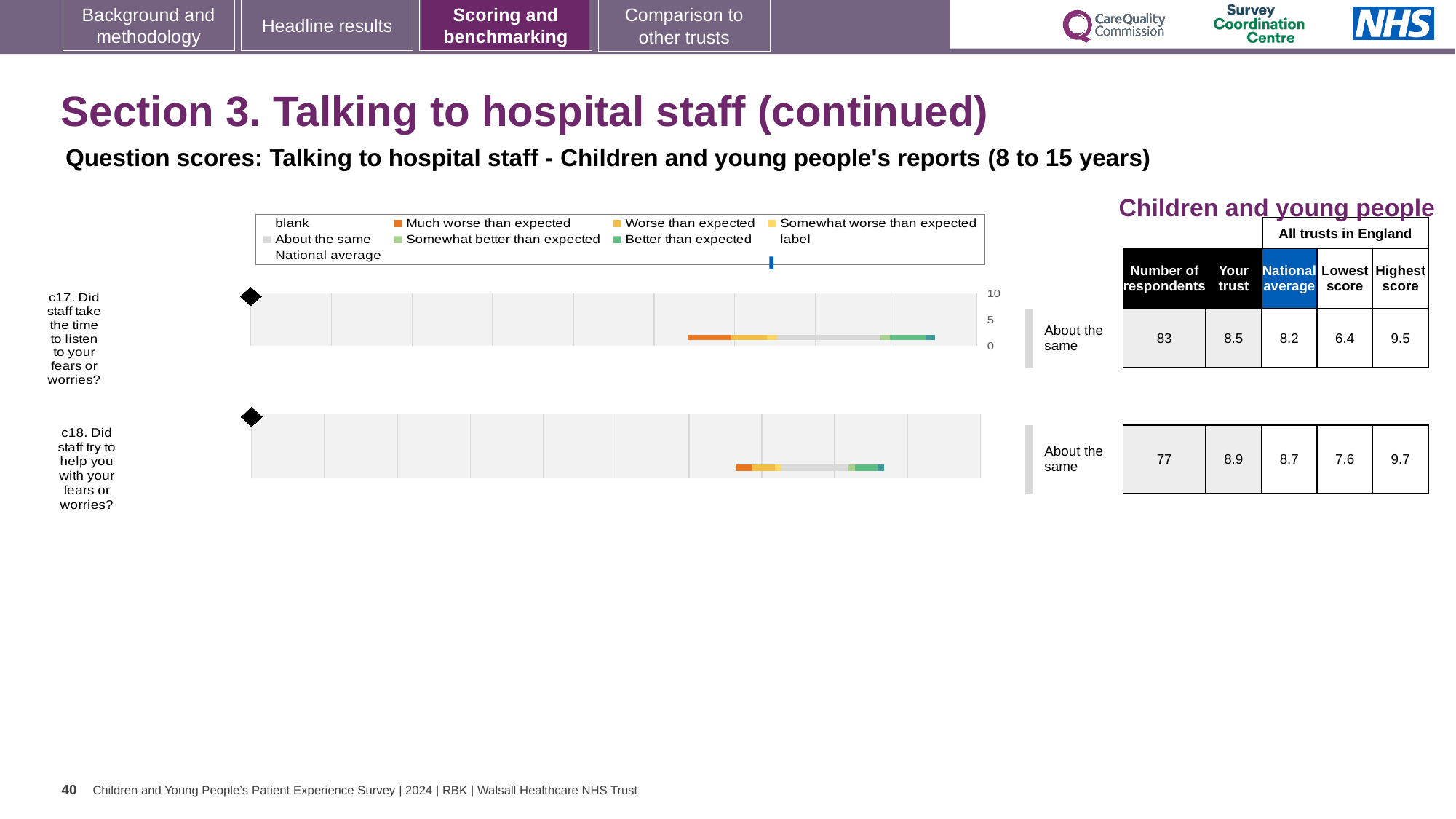
What is the difference between the 'Your trust' score and the national average for question c18? 0.2 How many respondents answered question c17? 83 How many survey questions are plotted on the chart? 2 What is the maximum value shown on the chart's score axis? 10 What kind of chart is used to show the question scores? Bar chart What benchmark category is shown for question c17? About the same What is the national average score for question c18 (Did staff try to help you with your fears or worries?)? 8.7 What is the 'Your trust' score for question c17 (Did staff take the time to listen to your fears or worries?)? 8.5 Which question has the higher 'Your trust' score, c17 or c18? c18 Which question had more respondents, c17 or c18? c17 What is the highest score among all trusts in England for question c17? 9.5 What is the lowest score among all trusts in England for question c18? 7.6